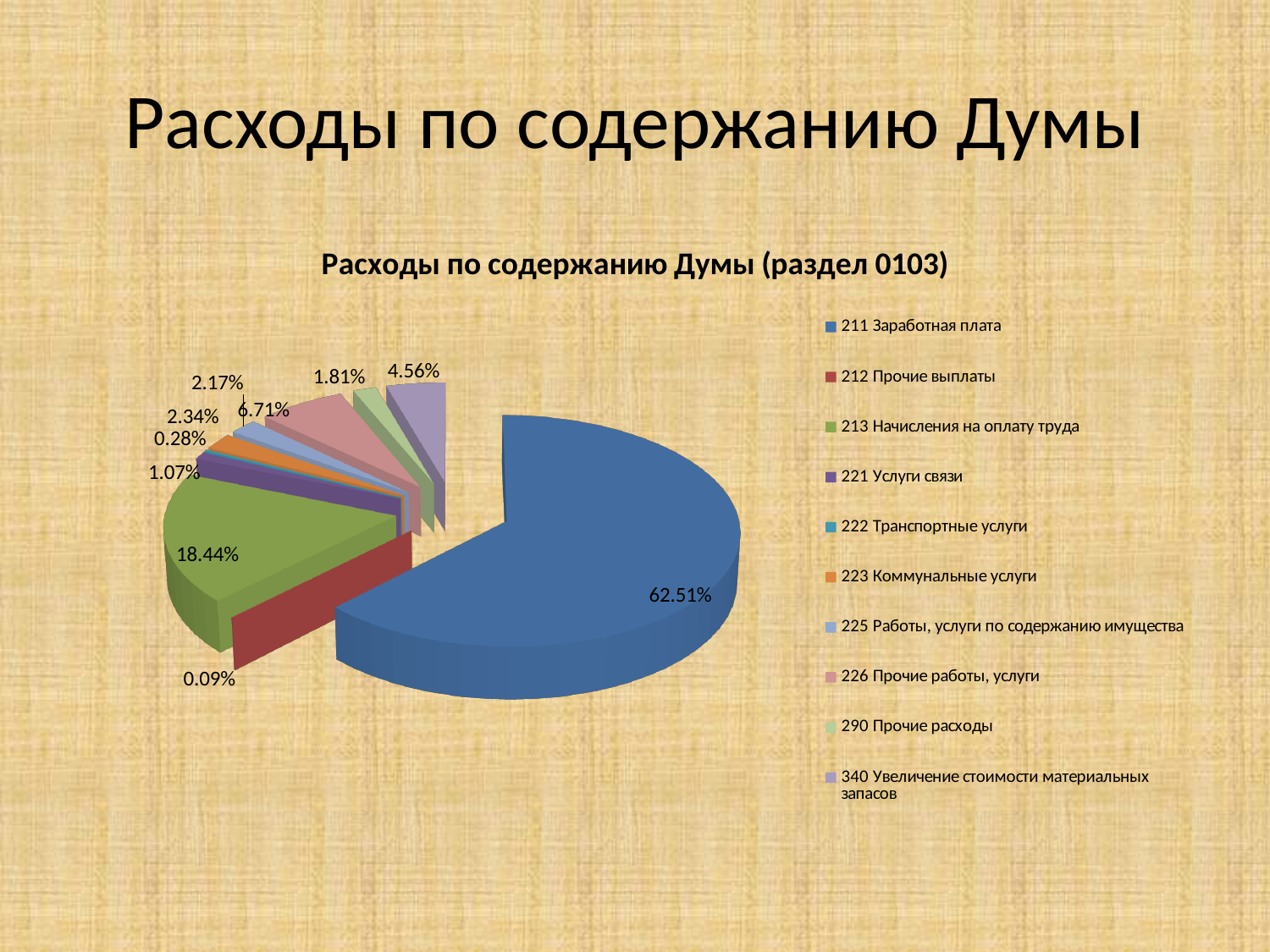
What is the value shown for 226 Прочие работы, услуги? 6.71% Which is larger: the share of 226 Прочие работы, услуги or the share of 340 Увеличение стоимости материальных запасов? 226 Прочие работы, услуги Which category has the smallest share of the pie? 212 Прочие выплаты What is the value shown for 340 Увеличение стоимости материальных запасов? 4.56% Which category has the largest share of the pie? 211 Заработная плата What is the difference between the shares of 211 Заработная плата and 213 Начисления на оплату труда? 44.07% What is the value shown for 213 Начисления на оплату труда? 18.44% What is the title of the chart? Расходы по содержанию Думы (раздел 0103) How many slices does the pie chart have? 10 How many entries does the chart legend list? 10 What share of the pie does 211 Заработная плата take? 62.51% What kind of chart is shown on the slide? pie chart